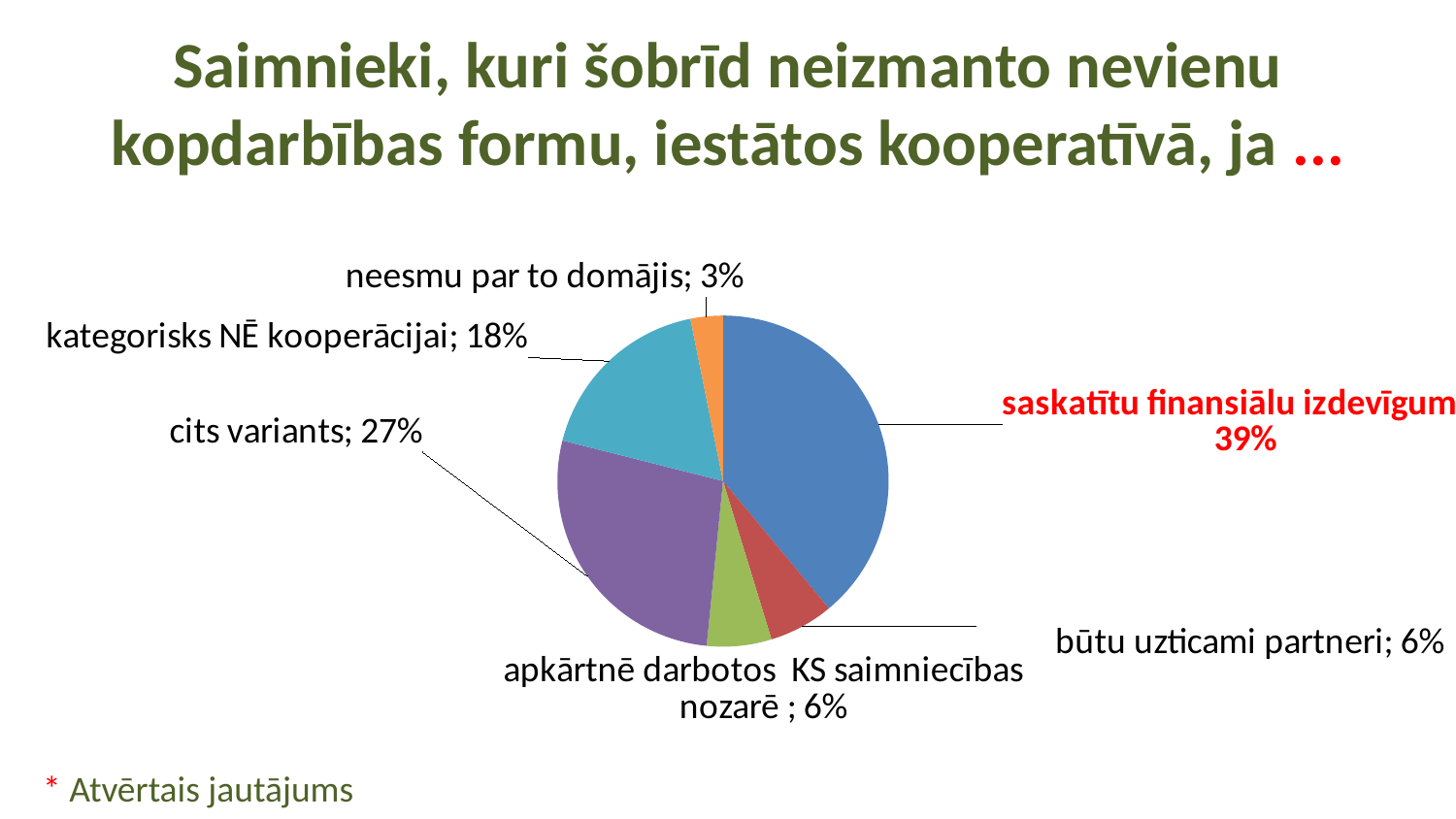
What kind of chart is shown on the slide? pie chart What is the value for 'būtu uzticami partneri'? 6% Which category has the smallest slice of the pie? neesmu par to domājis Which category has the largest slice of the pie? saskatītu finansiālu izdevīgumu What is the value for 'kategorisks NĒ kooperācijai'? 18% What is the value for 'cits variants'? 27% Which is larger, 'kategorisks NĒ kooperācijai' or 'cits variants'? cits variants What share of the pie does 'saskatītu finansiālu izdevīgumu' have? 39% What is the difference between 'saskatītu finansiālu izdevīgumu' and 'cits variants'? 12% Which category's label is printed in red on the slide? saskatītu finansiālu izdevīgumu How many slices does the pie chart have? 6 What is the value for 'neesmu par to domājis'? 3%